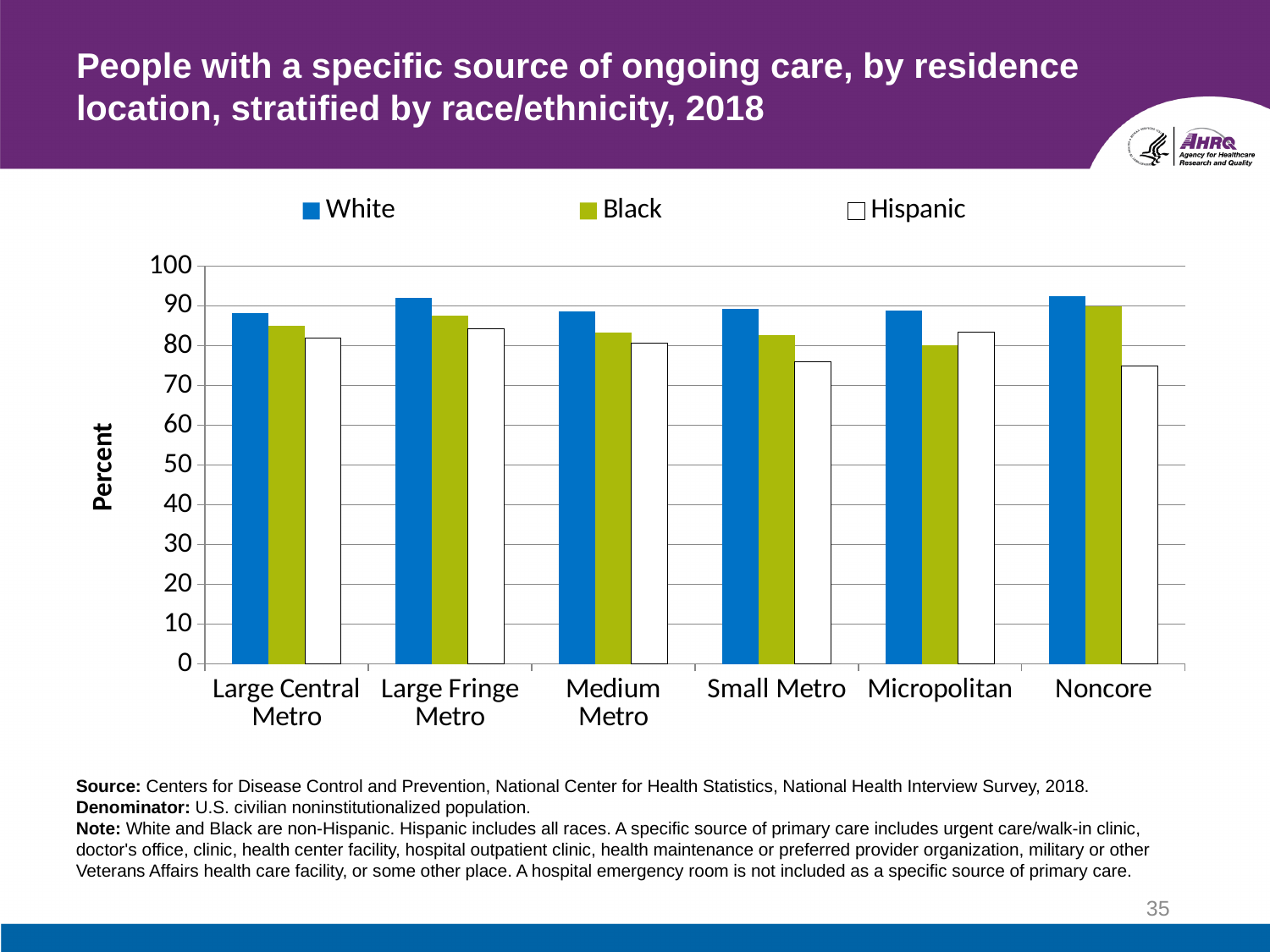
In Small Metro, which is larger: the White value or the Hispanic value? White Is the value for Black in Micropolitan greater or less than 90? less What is the label on the y axis? Percent Is the value for Hispanic in Small Metro greater or less than 80? less Is the value for White in Noncore greater or less than 90? greater What kind of chart is shown on the slide? bar chart How many series does the legend list? 3 How many residence location categories are shown on the x axis? 6 In Micropolitan, which is larger: the Black value or the Hispanic value? Hispanic In which residence location is the Black series highest? Noncore